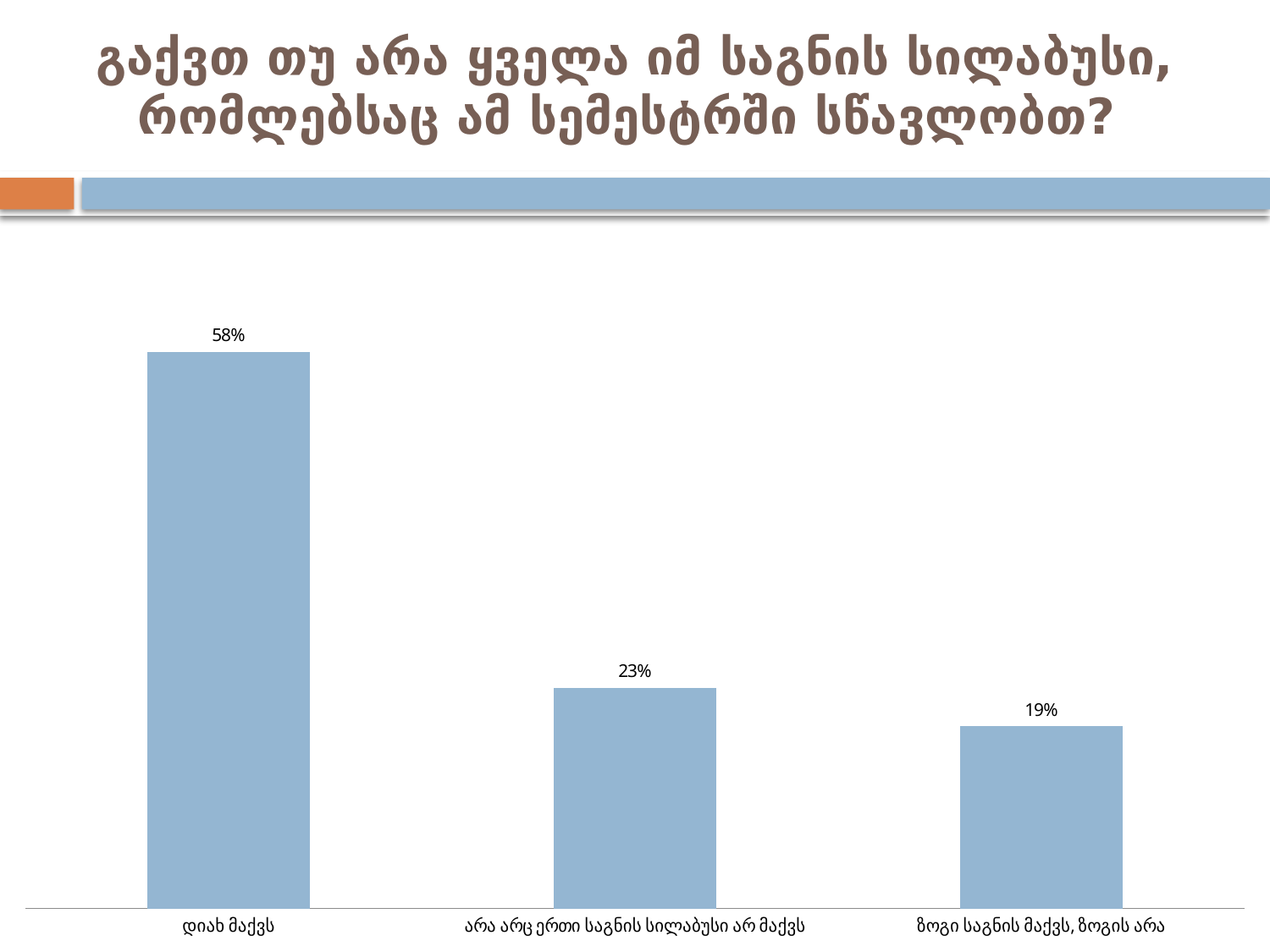
Which is larger: the value for "დიახ მაქვს" or the value for "ზოგი საგნის მაქვს, ზოგის არა"? დიახ მაქვს What is the difference between the values for "არა არც ერთი საგნის სილაბუსი არ მაქვს" and "ზოგი საგნის მაქვს, ზოგის არა"? 4% Do the values rise or fall from left to right across the categories? Fall What value is shown for the category "დიახ მაქვს"? 58% What is the difference between the values for "დიახ მაქვს" and "არა არც ერთი საგნის სილაბუსი არ მაქვს"? 35% What value is shown for the category "ზოგი საგნის მაქვს, ზოგის არა"? 19% How many categories are shown in the chart? 3 Which category has the highest value? დიახ მაქვს What kind of chart is shown on the slide? Bar chart What value is shown for the category "არა არც ერთი საგნის სილაბუსი არ მაქვს"? 23% Which category has the lowest value? ზოგი საგნის მაქვს, ზოგის არა What is the title of the slide? გაქვთ თუ არა ყველა იმ საგნის სილაბუსი, რომლებსაც ამ სემესტრში სწავლობთ?